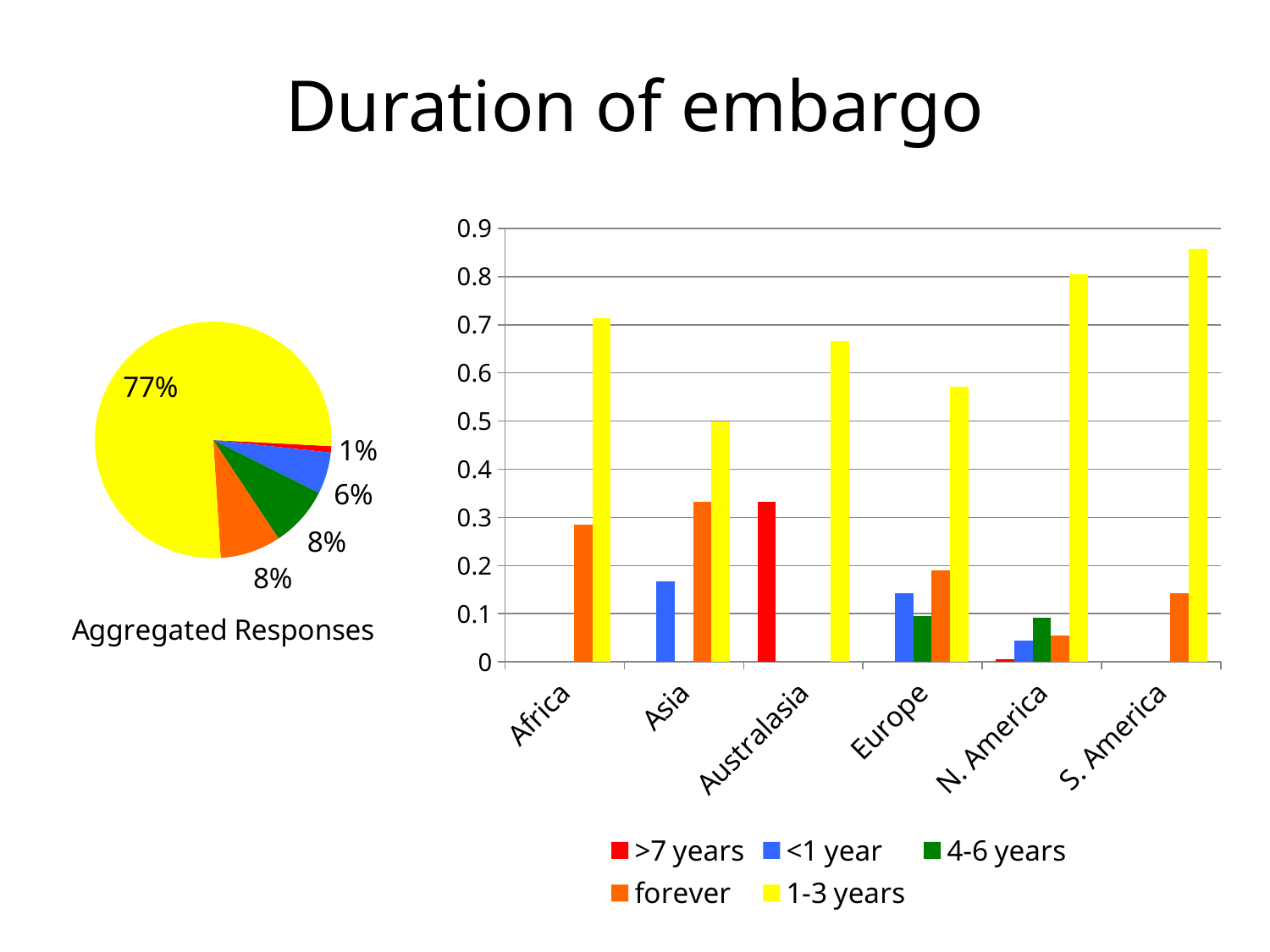
What kind of chart is the chart on the left titled "Aggregated Responses"? pie chart In the bar chart on the right, which region has the lowest "1-3 years" bar? Asia In the "Aggregated Responses" pie chart, what share does the largest slice have? 77% In the bar chart on the right, is the "1-3 years" value for S. America greater or less than 0.8? greater What kind of chart is the chart on the right showing regions? bar chart In the "Aggregated Responses" pie chart, what is the share of the smallest slice? 1% In the bar chart on the right, is the ">7 years" value for Australasia greater or less than 0.3? greater How many slices does the "Aggregated Responses" pie chart have? 5 In the bar chart on the right, which region has the highest "1-3 years" bar? S. America In the bar chart on the right, for Asia, which is larger: the "forever" bar or the "<1 year" bar? forever In the bar chart on the right, how many series does the legend list? 5 In the bar chart on the right, how many regions are shown on the x axis? 6